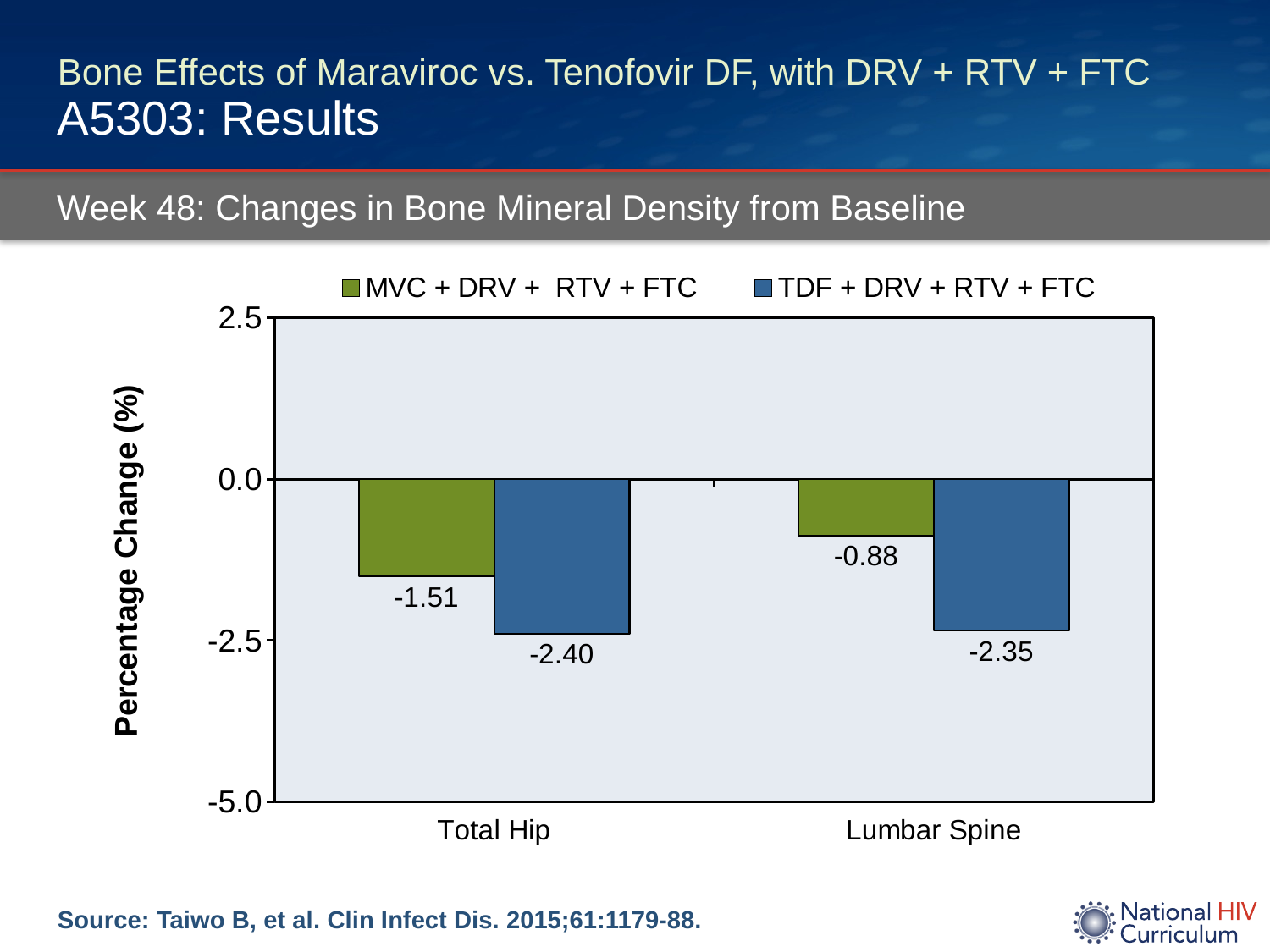
What is the difference between the TDF and MVC groups' percentage change at Total Hip? 0.89 What is the percentage change in bone mineral density at Total Hip for the TDF + DRV + RTV + FTC group? -2.40 At Lumbar Spine, which group had the greater decrease in bone mineral density, MVC + DRV + RTV + FTC or TDF + DRV + RTV + FTC? TDF + DRV + RTV + FTC What is the percentage change in bone mineral density at Lumbar Spine for the MVC + DRV + RTV + FTC group? -0.88 What is the percentage change in bone mineral density at Lumbar Spine for the TDF + DRV + RTV + FTC group? -2.35 What is the percentage change in bone mineral density at Total Hip for the MVC + DRV + RTV + FTC group? -1.51 How many series does the chart legend list? 2 What is the difference between the TDF and MVC groups' percentage change at Lumbar Spine? 1.47 How many categories are shown on the x axis of the chart? 2 Which bar shows the smallest decrease in bone mineral density? MVC + DRV + RTV + FTC at Lumbar Spine What type of chart is shown on the slide? Bar chart Which bar shows the largest decrease in bone mineral density? TDF + DRV + RTV + FTC at Total Hip